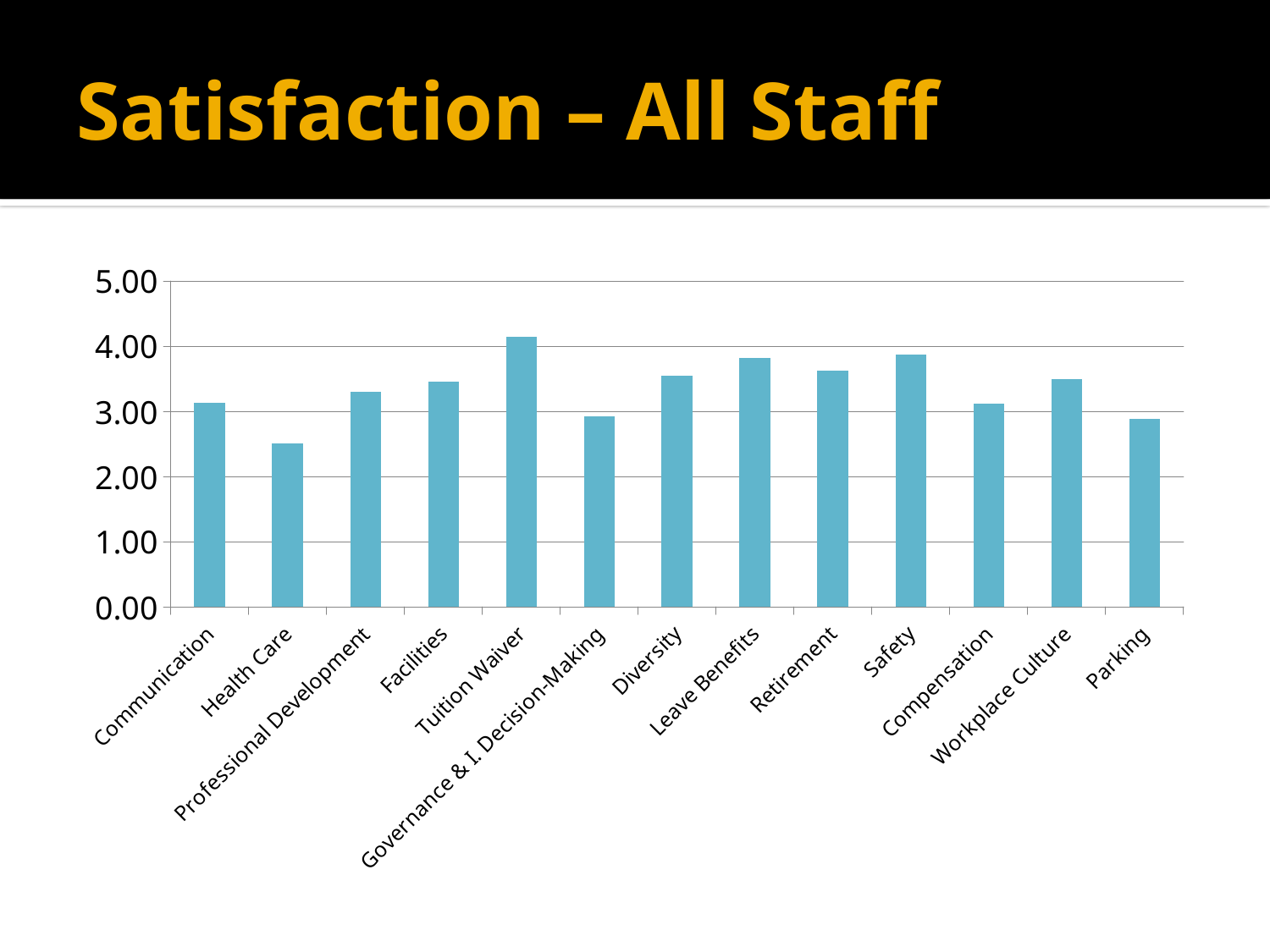
How many categories are shown on the x axis of the chart? 13 What kind of chart is shown on the slide? Bar chart What is the title of the slide containing the chart? Satisfaction – All Staff Which is larger, the value for Health Care or the value for Parking? Parking Which is larger, the value for Facilities or the value for Communication? Facilities Which category has the highest satisfaction score? Tuition Waiver Which category has the lowest satisfaction score? Health Care Is the value for Health Care greater or less than 3.00? less Is the value for Safety greater or less than 4.00? less Is the value for Tuition Waiver greater or less than 4.00? greater